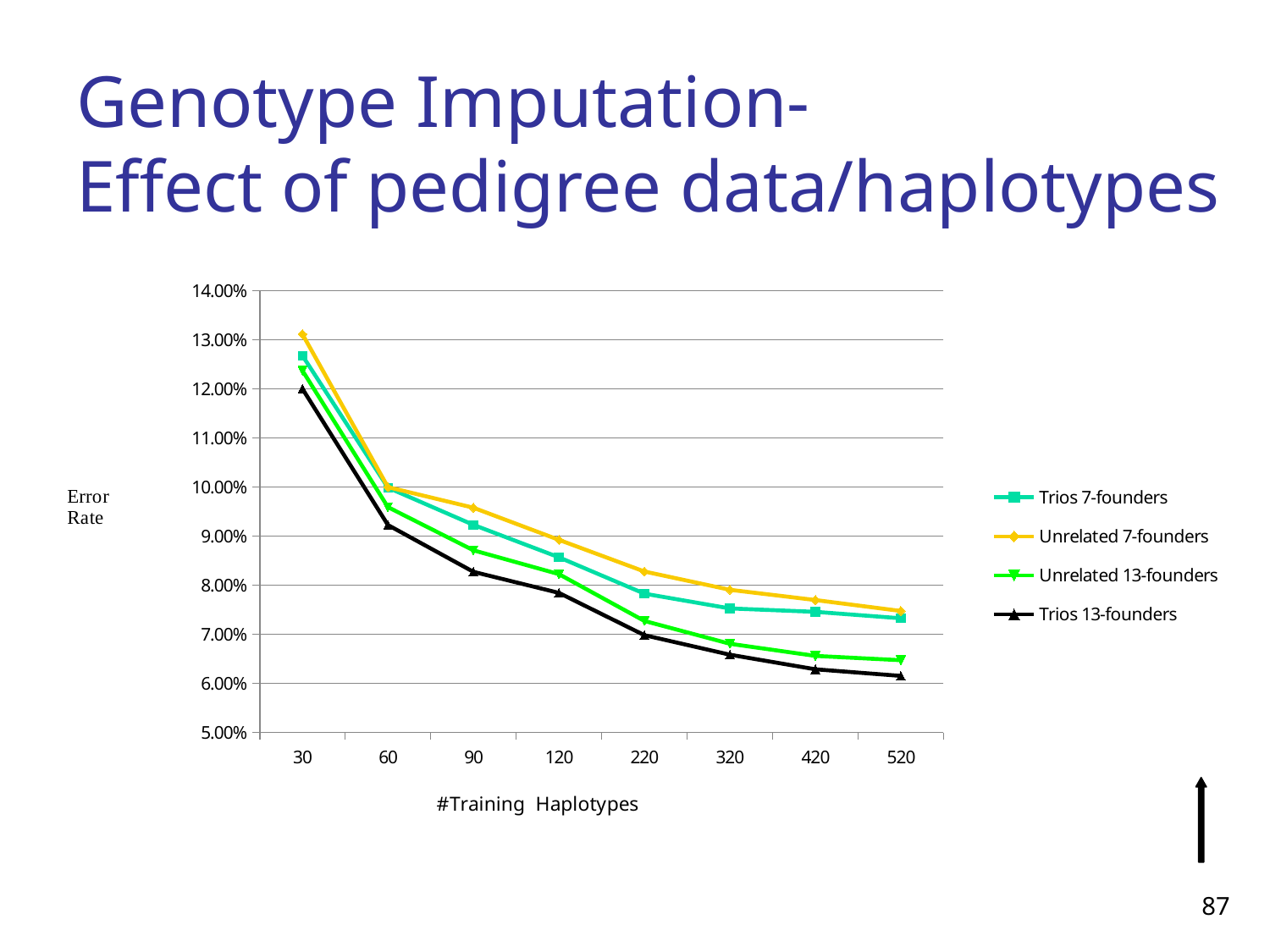
At 30 training haplotypes, which has the larger error rate: Unrelated 7-founders or Trios 13-founders? Unrelated 7-founders Is the error rate for Unrelated 13-founders at 60 training haplotypes greater or less than 10.00%? less What is the label of the x axis? #Training Haplotypes What kind of chart is shown on the slide? line chart Which series has the highest error rate at 30 training haplotypes? Unrelated 7-founders How many #Training Haplotypes values are plotted along the x axis? 8 Does the error rate rise or fall as the number of training haplotypes increases? fall How many series does the legend list? 4 Which series has the lowest error rate at 520 training haplotypes? Trios 13-founders Is the error rate for Trios 13-founders at 520 training haplotypes greater or less than 7.00%? less At 520 training haplotypes, which has the larger error rate: Trios 7-founders or Unrelated 13-founders? Trios 7-founders Which series has the highest error rate at 520 training haplotypes? Unrelated 7-founders